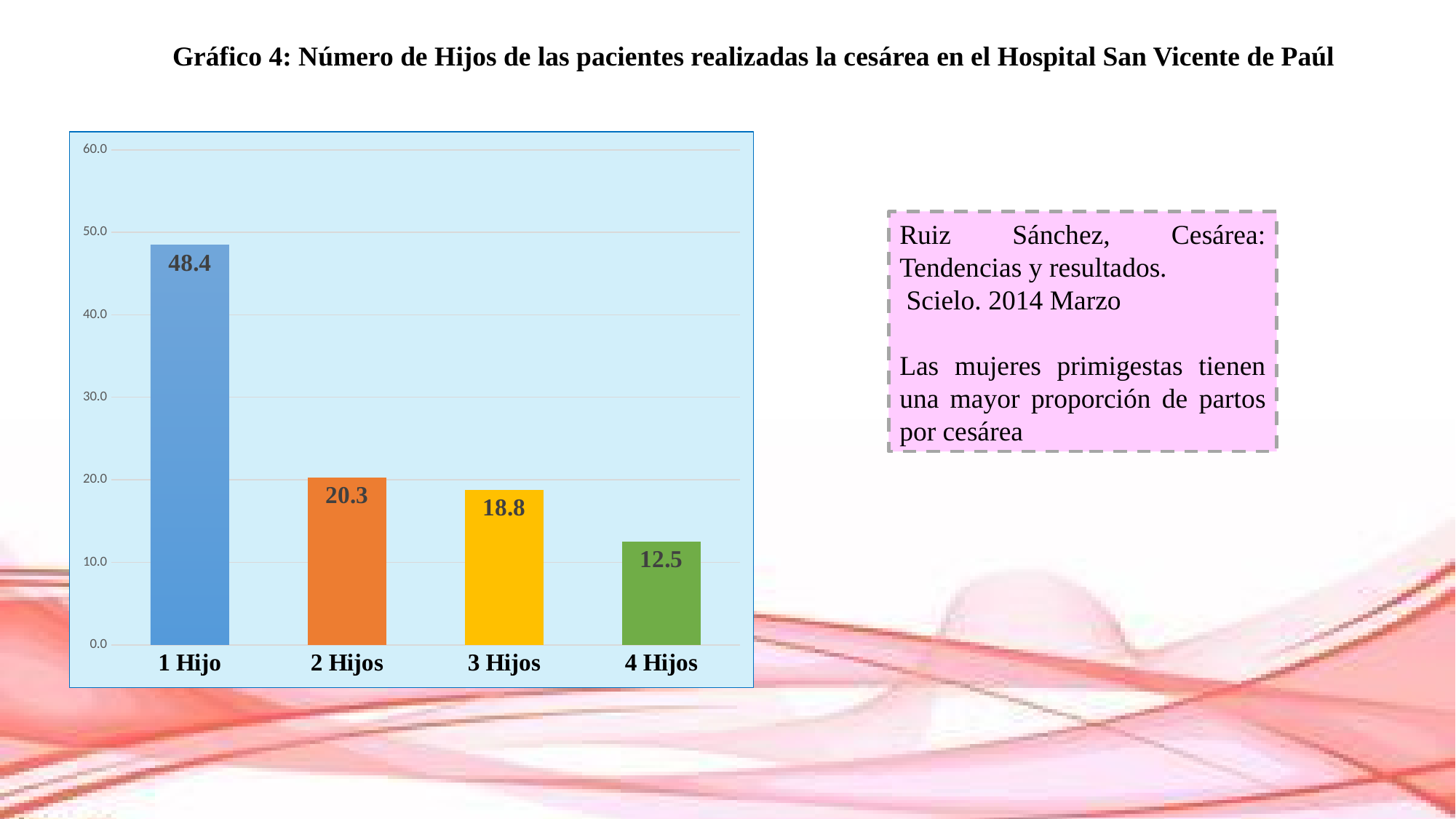
What is the value for 2 Hijos? 20.3 Which is larger, the value for 2 Hijos or the value for 3 Hijos? 2 Hijos Which category has the lowest value? 4 Hijos Which category has the highest value? 1 Hijo What kind of chart is shown on the slide? Bar chart How many categories are shown on the x axis? 4 What is the difference between the values for 3 Hijos and 4 Hijos? 6.3 What is the value for 1 Hijo? 48.4 What is the difference between the values for 1 Hijo and 2 Hijos? 28.1 What is the value for 4 Hijos? 12.5 Do the values rise or fall from 1 Hijo to 4 Hijos along the x axis? Fall What is the value for 3 Hijos? 18.8